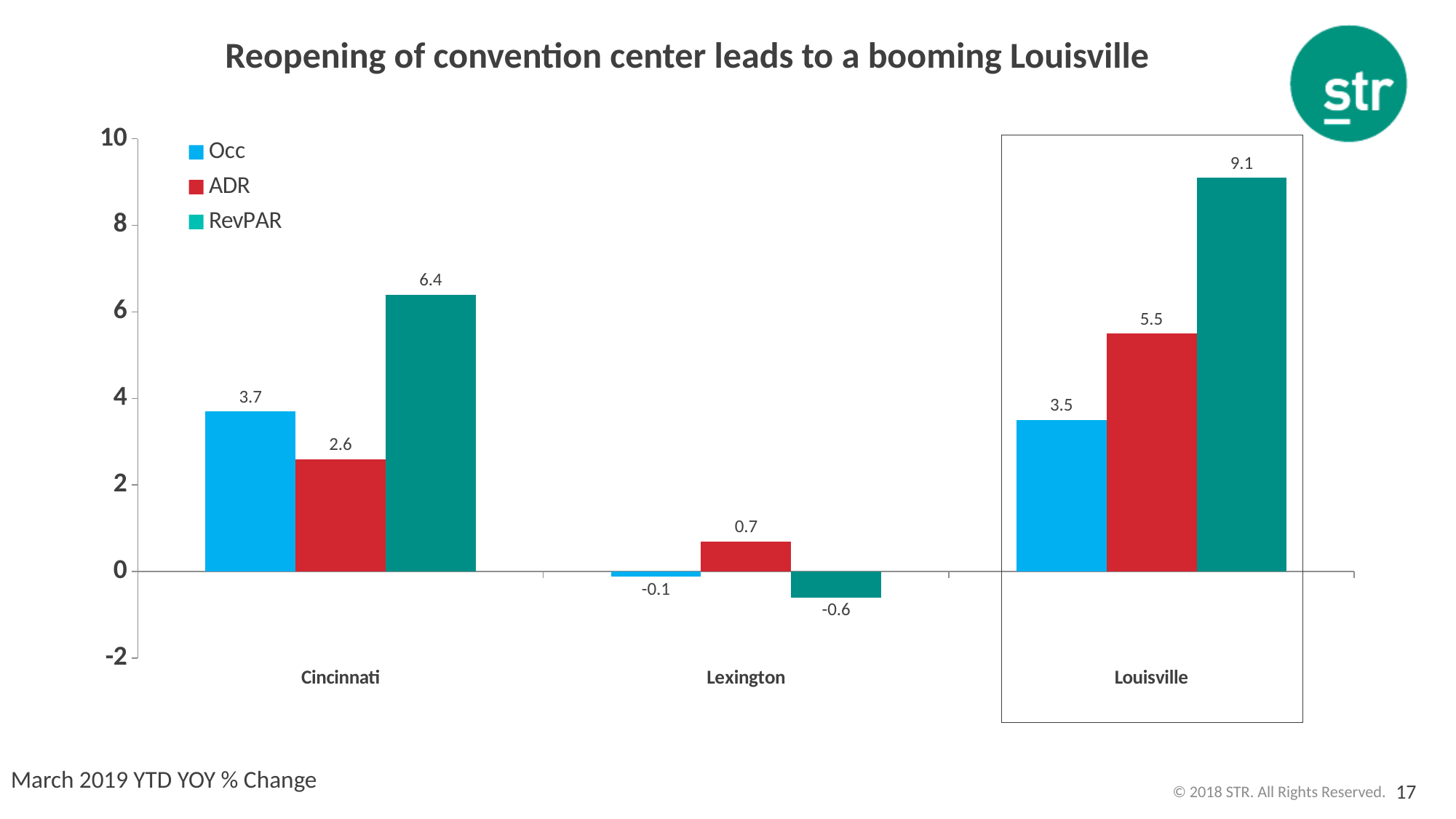
What is the RevPAR value for Lexington? -0.6 Which is larger, the ADR value for Louisville or the ADR value for Cincinnati? Louisville What is the RevPAR value for Louisville? 9.1 Which city has the highest RevPAR value? Louisville Which city has the lowest Occ value? Lexington What kind of chart is shown on the slide? bar chart How many series does the legend list? 3 What is the difference between the RevPAR values for Louisville and Cincinnati? 2.7 What is the ADR value for Lexington? 0.7 What is the Occ value for Cincinnati? 3.7 How many cities are shown on the x axis? 3 Is the RevPAR value for Cincinnati greater or less than 6? greater